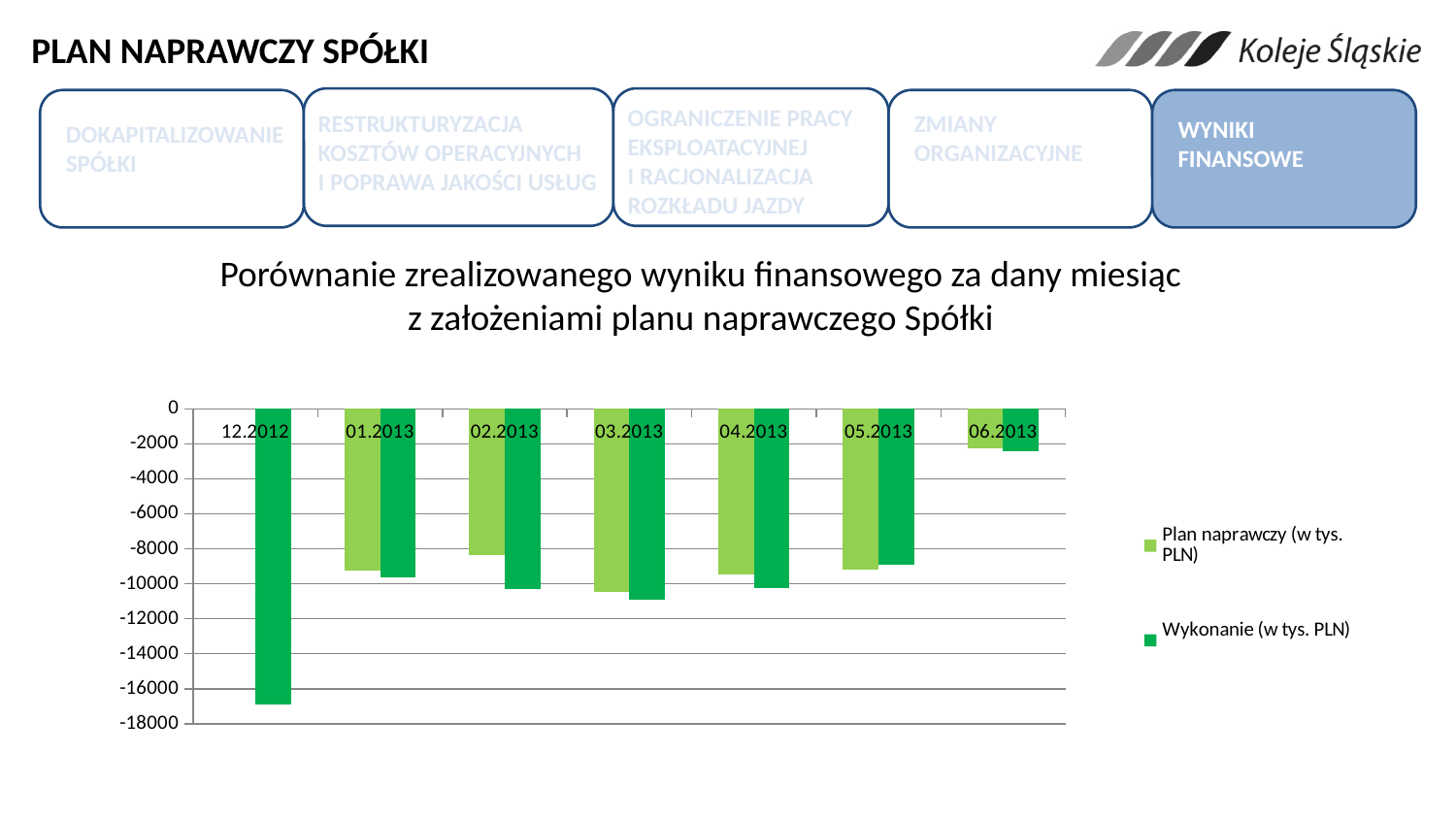
Which category has the lowest (most negative) Wykonanie (w tys. PLN) value? 12.2012 How many series does the chart legend list? 2 Which series is shown in dark green in the chart? Wykonanie (w tys. PLN) What kind of chart is shown on the slide? bar chart Is the Plan naprawczy (w tys. PLN) value for 02.2013 greater or less than -10000? greater For 02.2013, which series has the more negative value, Plan naprawczy (w tys. PLN) or Wykonanie (w tys. PLN)? Wykonanie (w tys. PLN) Is the Plan naprawczy (w tys. PLN) value for 06.2013 greater or less than -4000? greater Is the Plan naprawczy (w tys. PLN) value for 01.2013 greater or less than -10000? greater How many month categories are shown on the x axis of the chart? 7 What is the first category on the x axis of the chart? 12.2012